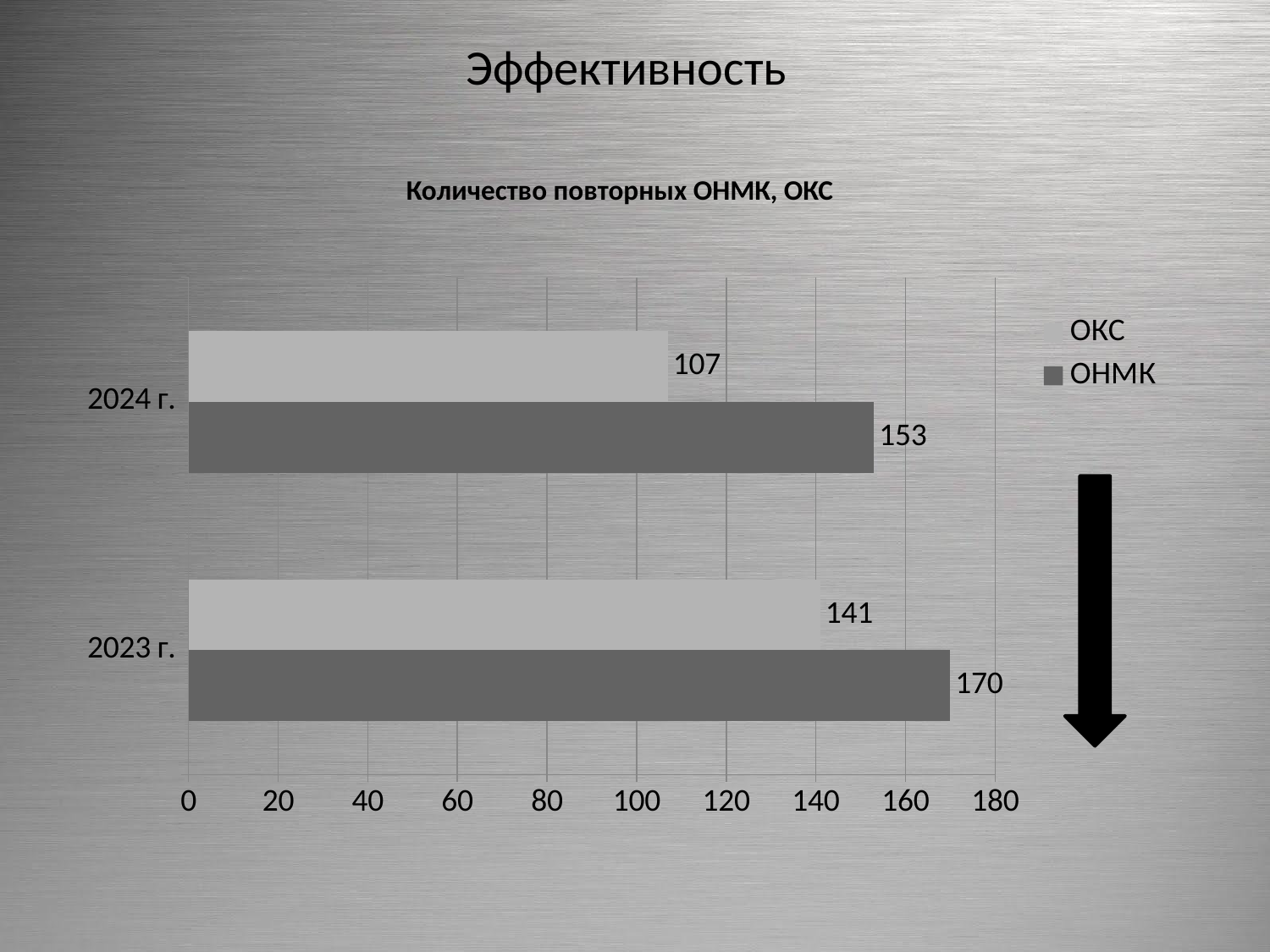
What is the value for ОКС in 2024 г.? 107 Which year has the lower value for ОКС? 2024 г. What is the title of the chart? Количество повторных ОНМК, ОКС What is the value for ОНМК in 2023 г.? 170 What is the difference between the ОНМК values for 2023 г. and 2024 г.? 17 What is the difference between the ОКС values for 2023 г. and 2024 г.? 34 How many series does the legend list? 2 Which year has the higher value for ОНМК? 2023 г. Which is larger in 2024 г.: ОКС or ОНМК? ОНМК What is the value for ОНМК in 2024 г.? 153 What kind of chart is shown on the slide? Bar chart What is the value for ОКС in 2023 г.? 141